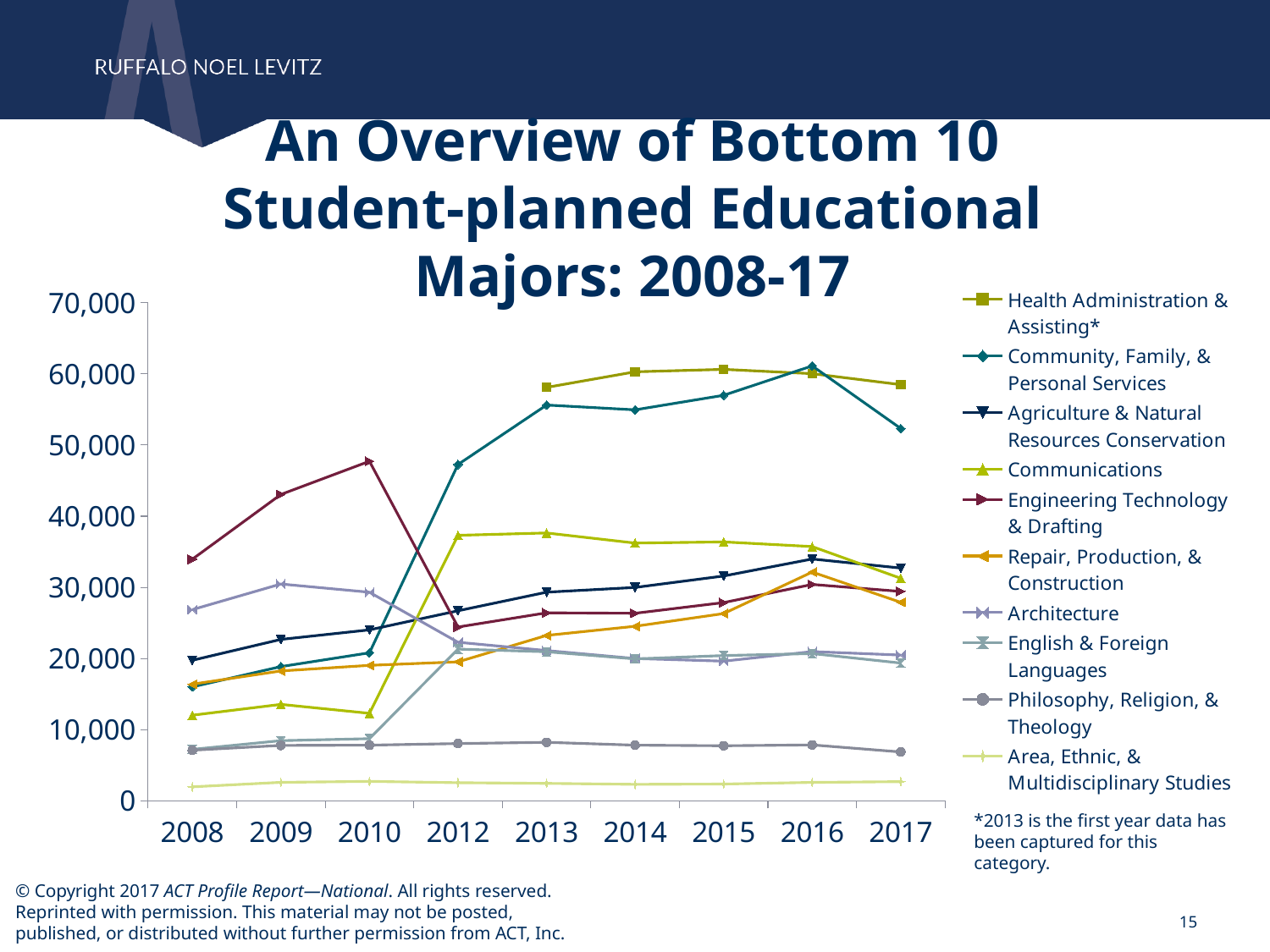
Does the value for Engineering Technology & Drafting rise or fall from 2010 to 2012? fall How many series does the legend list? 10 Is the value for Health Administration & Assisting in 2013 greater or less than 50,000? greater According to the footnote, what is the first year data was captured for Health Administration & Assisting? 2013 How many years are plotted along the x axis? 9 Which series has the highest value in 2010? Engineering Technology & Drafting In 2009, which is larger: Engineering Technology & Drafting or Architecture? Engineering Technology & Drafting Is the value for Engineering Technology & Drafting in 2010 greater or less than 40,000? greater Is the value for Community, Family, & Personal Services in 2008 greater or less than 20,000? less What kind of chart is shown on the slide? Line chart Which series has the lowest values across all years shown? Area, Ethnic, & Multidisciplinary Studies